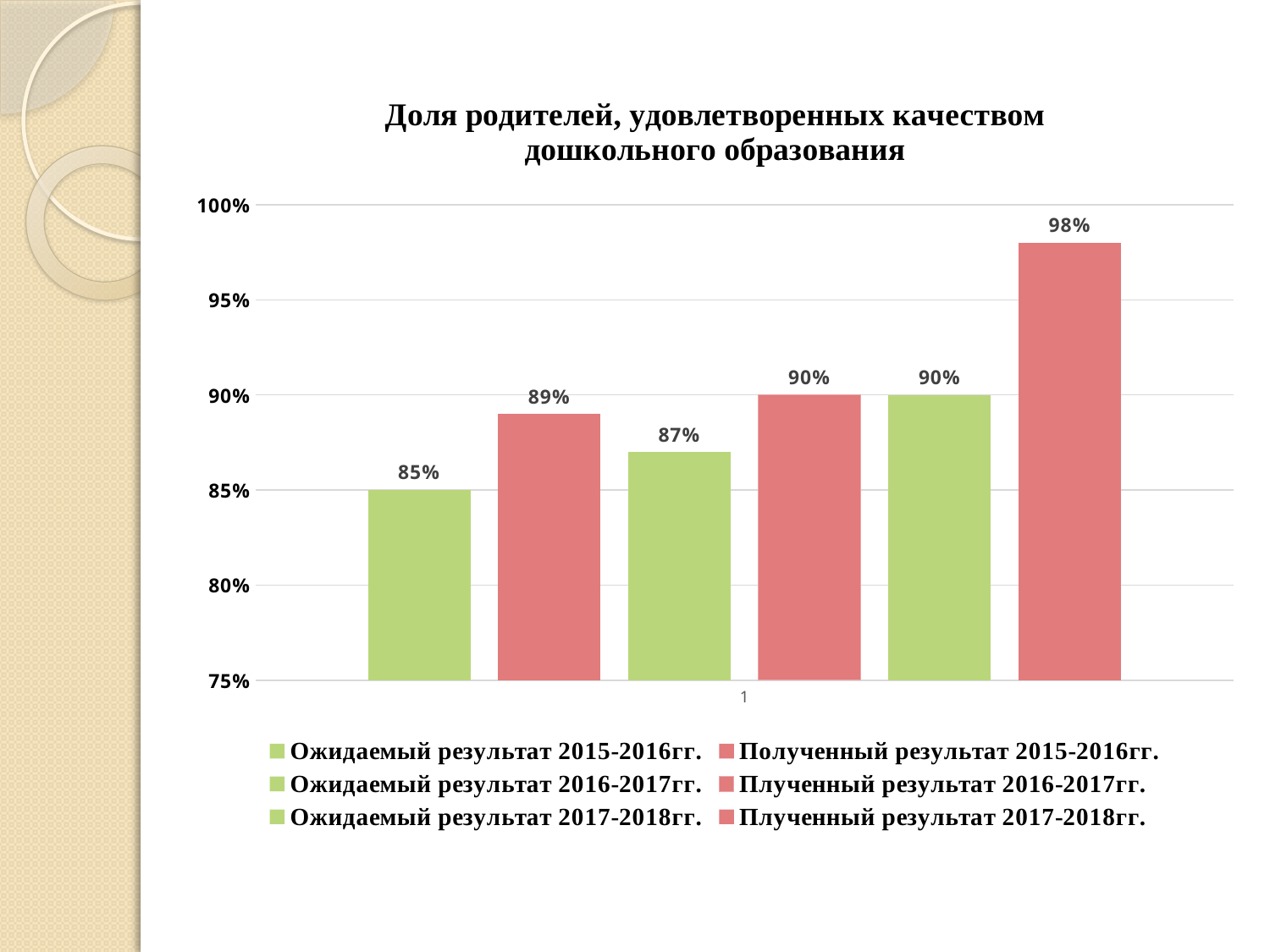
Which series has the highest value? Плученный результат 2017-2018гг. What is the value for Ожидаемый результат 2016-2017гг.? 87% Which is larger: Ожидаемый результат 2016-2017гг. or Плученный результат 2016-2017гг.? Плученный результат 2016-2017гг. Which series has the lowest value? Ожидаемый результат 2015-2016гг. What is the value for Полученный результат 2015-2016гг.? 89% What is the value for Плученный результат 2017-2018гг.? 98% How many series does the legend list? 6 What is the difference between Плученный результат 2017-2018гг. and Ожидаемый результат 2017-2018гг.? 8% What kind of chart is shown? Bar chart What is the title of the chart? Доля родителей, удовлетворенных качеством дошкольного образования What is the value for Ожидаемый результат 2015-2016гг.? 85% What is the difference between Полученный результат 2015-2016гг. and Ожидаемый результат 2015-2016гг.? 4%